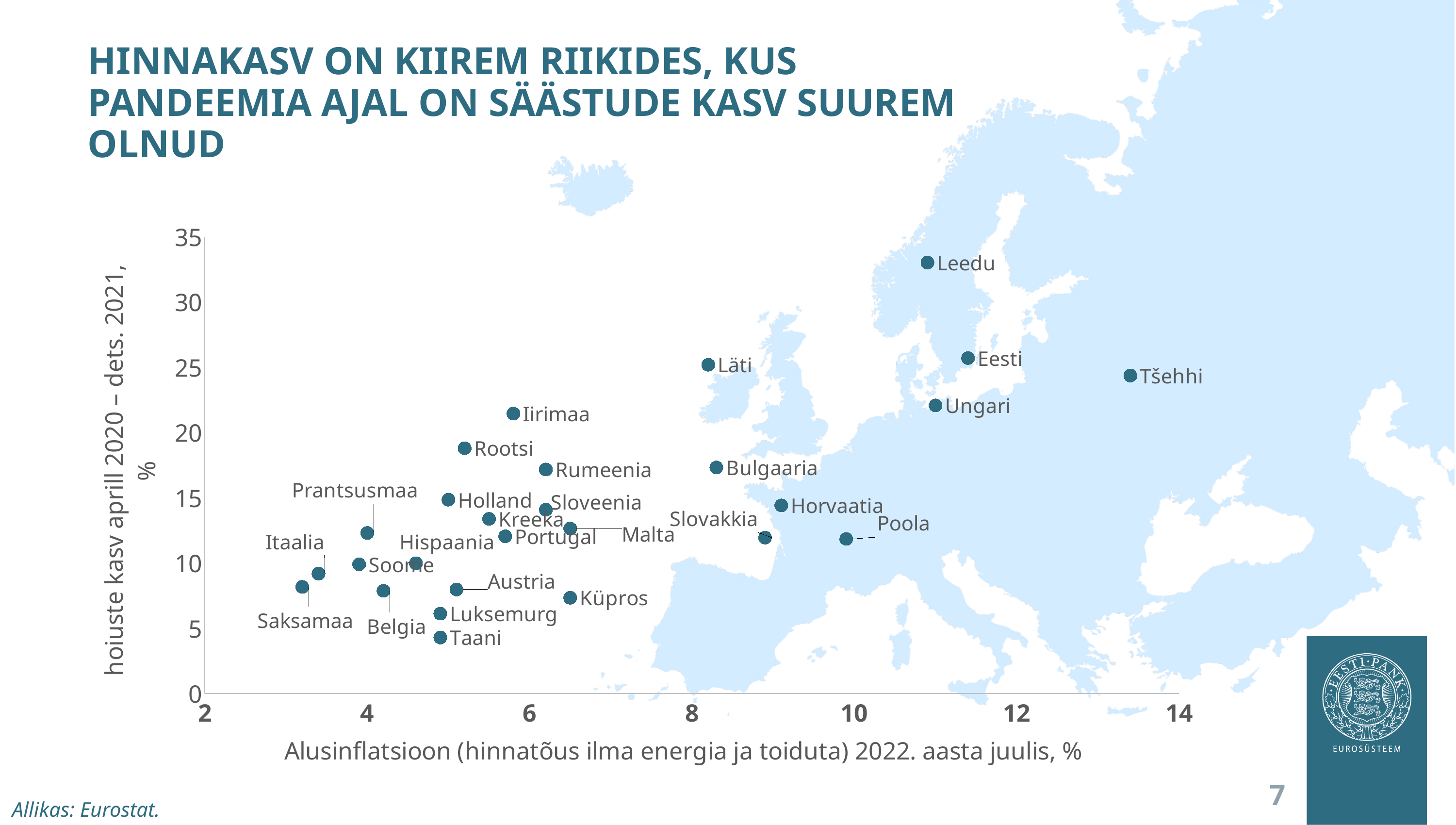
Which country has the highest core inflation (horizontal axis) on the chart? Tšehhi Which has higher deposit growth, Läti or Bulgaaria? Läti Which has higher core inflation, Poola or Holland? Poola How many countries are plotted on the chart? 27 Which country has the lowest deposit growth (vertical axis) on the chart? Taani Which country has the highest deposit growth (vertical axis) on the chart? Leedu What kind of chart is shown on the slide? scatter chart Is the deposit growth value for Taani greater or less than 5? less Is the deposit growth value for Leedu greater or less than 30? greater What is the source cited for the chart? Eurostat Is the core inflation value for Tšehhi greater or less than 12? greater Which country has the lowest core inflation (horizontal axis) on the chart? Saksamaa